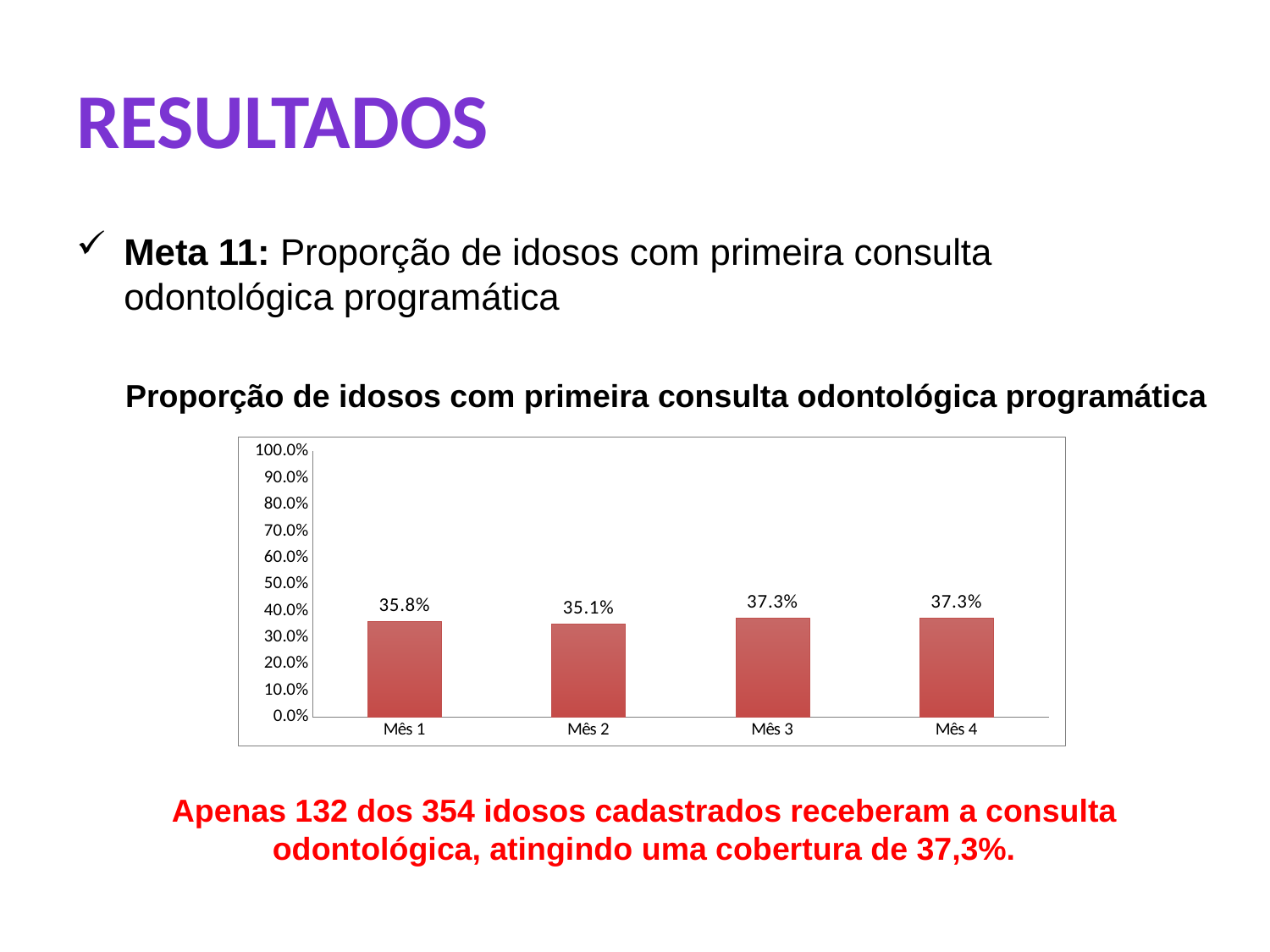
What is the value for Mês 1? 35.8% Which month has the lowest value? Mês 2 Which is larger, the value for Mês 1 or the value for Mês 4? Mês 4 What is the value for Mês 2? 35.1% What kind of chart is shown on the slide? bar chart What is the title of the chart? Proporção de idosos com primeira consulta odontológica programática What is the value for Mês 3? 37.3% How many months are shown on the x axis? 4 What is the difference between the values for Mês 3 and Mês 2? 2.2% Is the value for Mês 3 greater or less than 50.0%? less What is the difference between the values for Mês 1 and Mês 2? 0.7% What is the value for Mês 4? 37.3%